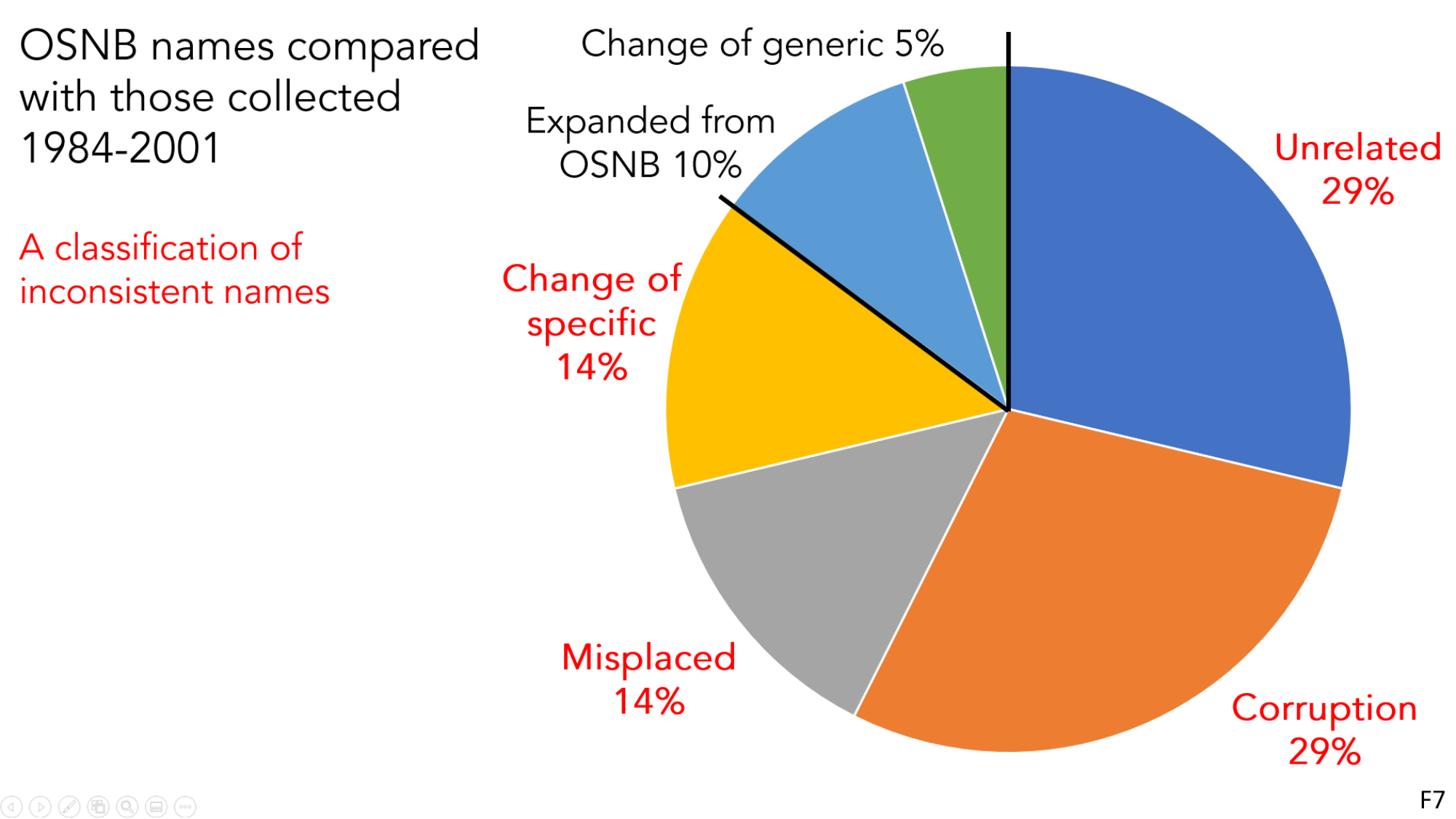
What share of the pie is labelled Corruption? 29% What is the difference in percentage points between the Unrelated slice and the Change of generic slice? 24 What kind of chart is shown on the slide? pie chart What share of the pie is labelled Expanded from OSNB? 10% What share of the pie is labelled Change of generic? 5% Which category has the smallest slice of the pie? Change of generic Which is larger, the Misplaced slice or the Expanded from OSNB slice? Misplaced How many slices does the pie chart have? 6 What colour is the Corruption slice? orange